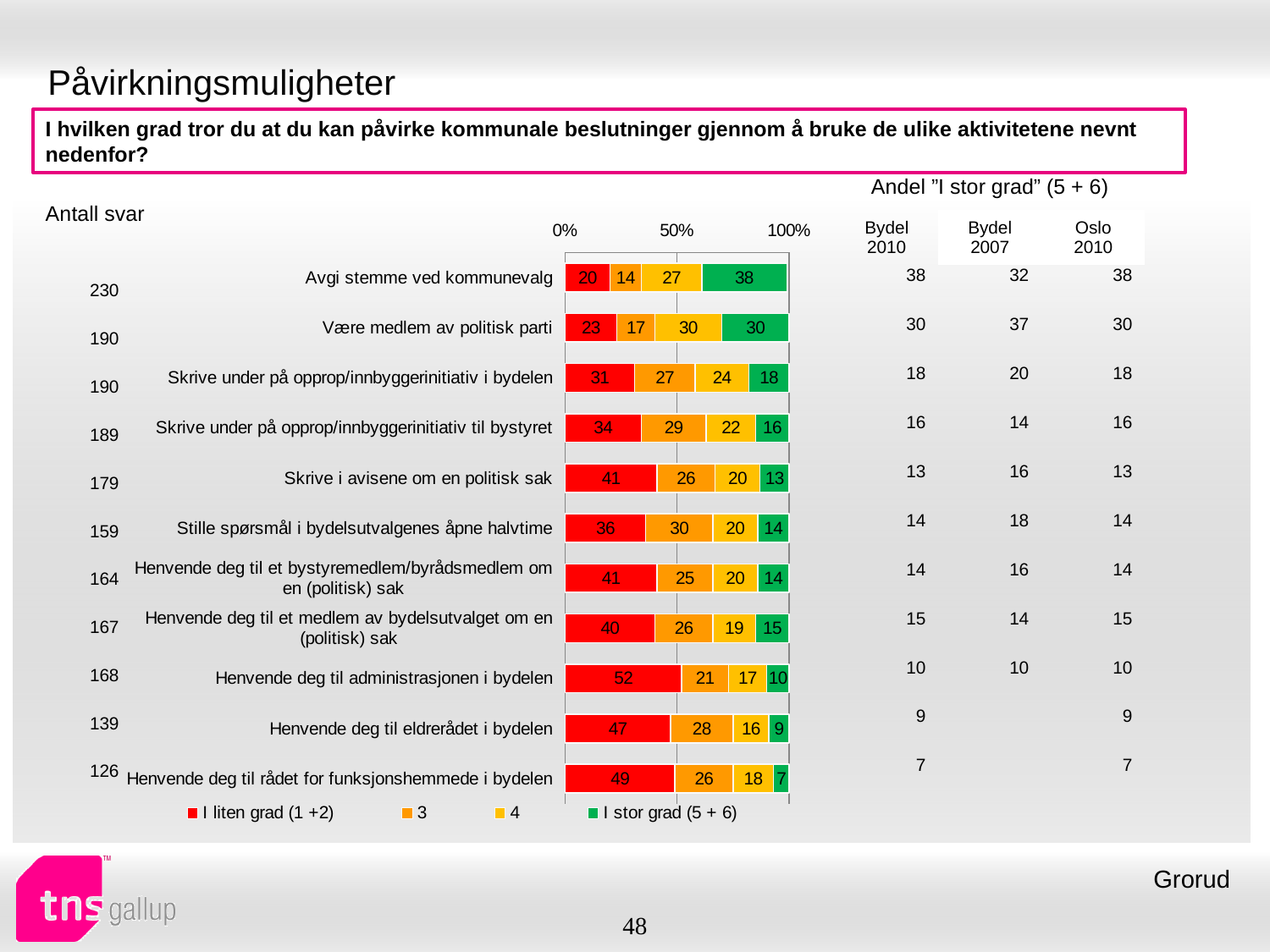
How many categories (activities) are plotted in the chart? 11 What is the difference between the 'I liten grad (1 +2)' values for 'Henvende deg til administrasjonen i bydelen' and 'Avgi stemme ved kommunevalg'? 32 Which has a larger 'I liten grad (1 +2)' value: 'Henvende deg til eldrerådet i bydelen' or 'Skrive i avisene om en politisk sak'? Henvende deg til eldrerådet i bydelen What is the value of series '3' for 'Skrive under på opprop/innbyggerinitiativ til bystyret'? 29 Which category has the highest value for 'I stor grad (5 + 6)'? Avgi stemme ved kommunevalg What is the value of 'I stor grad (5 + 6)' for 'Avgi stemme ved kommunevalg'? 38 Which category has the lowest value for 'I stor grad (5 + 6)'? Henvende deg til rådet for funksjonshemmede i bydelen Which colour represents 'I stor grad (5 + 6)' in the chart? Green What is the value of 'I liten grad (1 +2)' for 'Henvende deg til administrasjonen i bydelen'? 52 What is the total of the stacked bar for 'Være medlem av politisk parti'? 100 How many series does the chart legend list? 4 What kind of chart is shown on the slide? Stacked bar chart